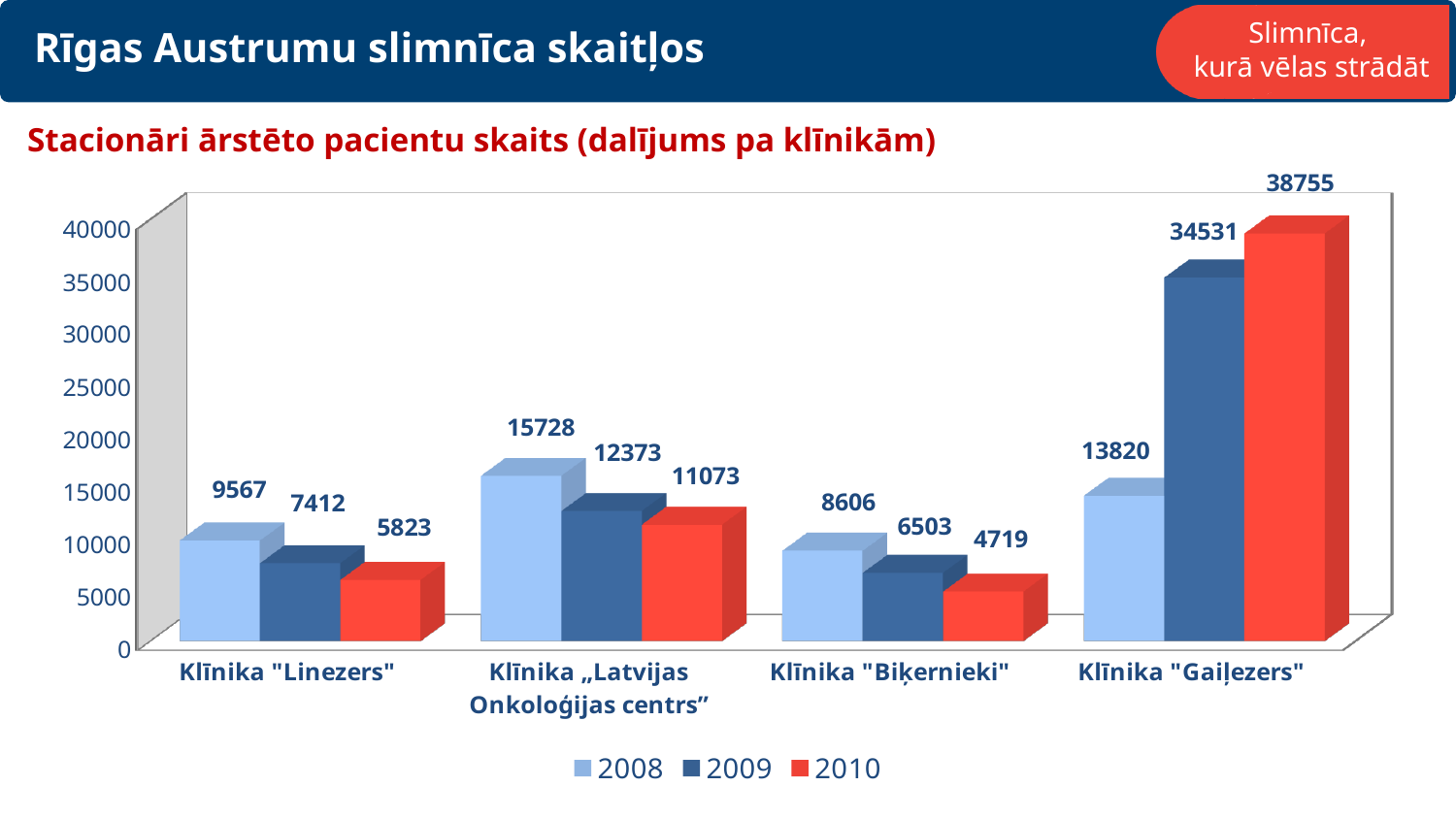
What was the number of inpatients treated at Klīnika "Linezers" in 2008? 9567 Which clinic had the highest number of inpatients in 2010? Klīnika "Gaiļezers" Which is larger: the 2008 value for Klīnika "Linezers" or the 2010 value for Klīnika „Latvijas Onkoloģijas centrs”? 2010 value for Klīnika „Latvijas Onkoloģijas centrs” What was the number of inpatients treated at Klīnika "Gaiļezers" in 2010? 38755 What was the number of inpatients treated at Klīnika "Biķernieki" in 2009? 6503 What is the difference between the 2008 and 2010 values for Klīnika „Latvijas Onkoloģijas centrs”? 4655 Which clinic had the lowest number of inpatients in 2008? Klīnika "Biķernieki" What is the difference between the 2009 and 2010 values for Klīnika "Gaiļezers"? 4224 For Klīnika "Gaiļezers", do the values rise or fall from 2008 to 2010? Rise How many clinics are shown on the x axis? 4 What kind of chart is shown on the slide? Bar chart How many series does the legend list? 3